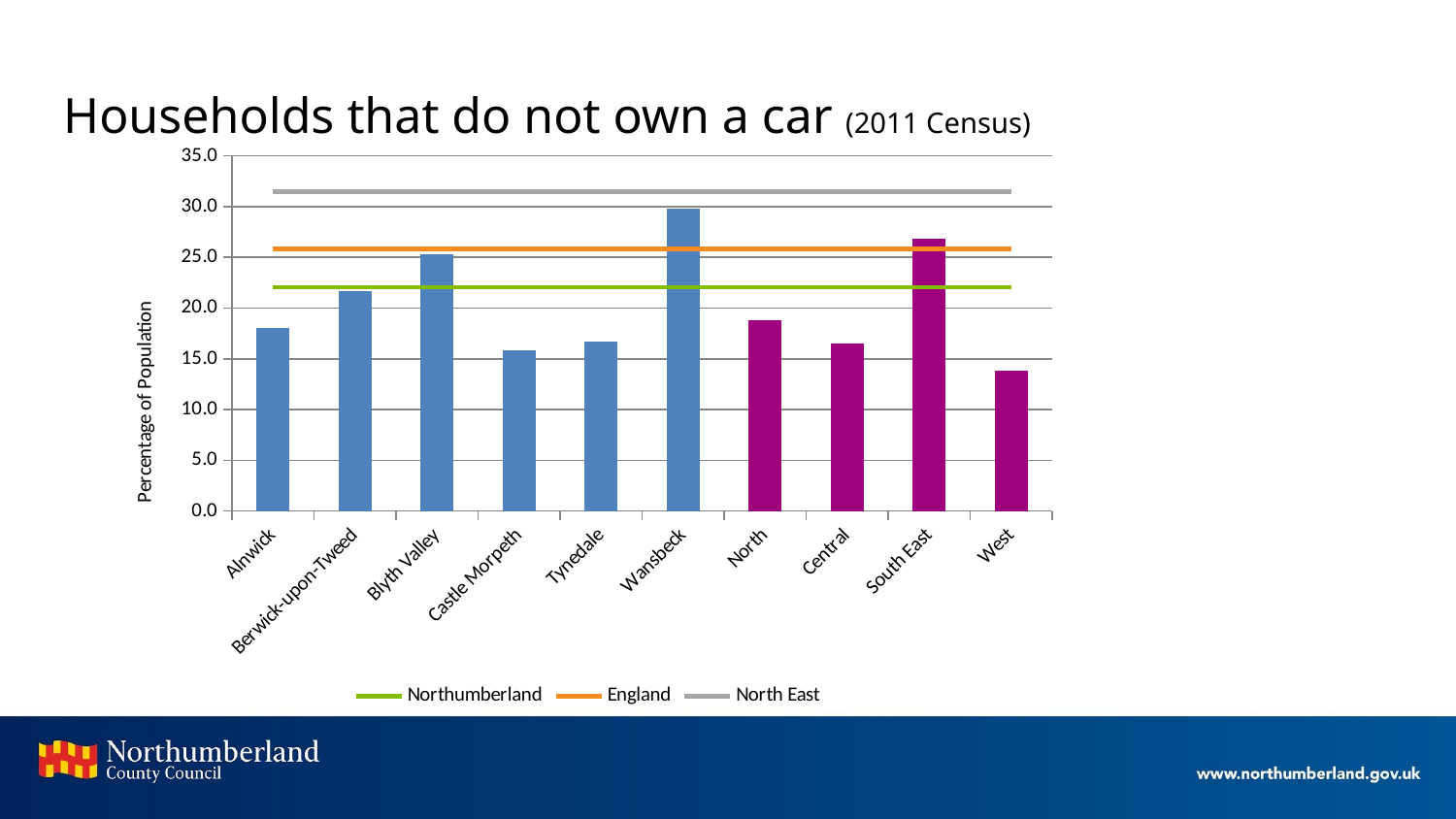
Which area has the lowest percentage of households that do not own a car? West What is the label on the y axis? Percentage of Population What kind of chart is shown on the slide? Bar chart What is the title of the chart? Households that do not own a car (2011 Census) Is the value for Wansbeck greater or less than 25.0? greater Which area has the highest percentage of households that do not own a car? Wansbeck Is the value for Castle Morpeth greater or less than 20.0? less How many areas are plotted as bars along the x axis? 10 How many entries does the legend list? 3 Which is larger, the value for South East or the value for Central? South East Which is larger, the value for Blyth Valley or the value for Tynedale? Blyth Valley Is the value for West greater or less than 15.0? less